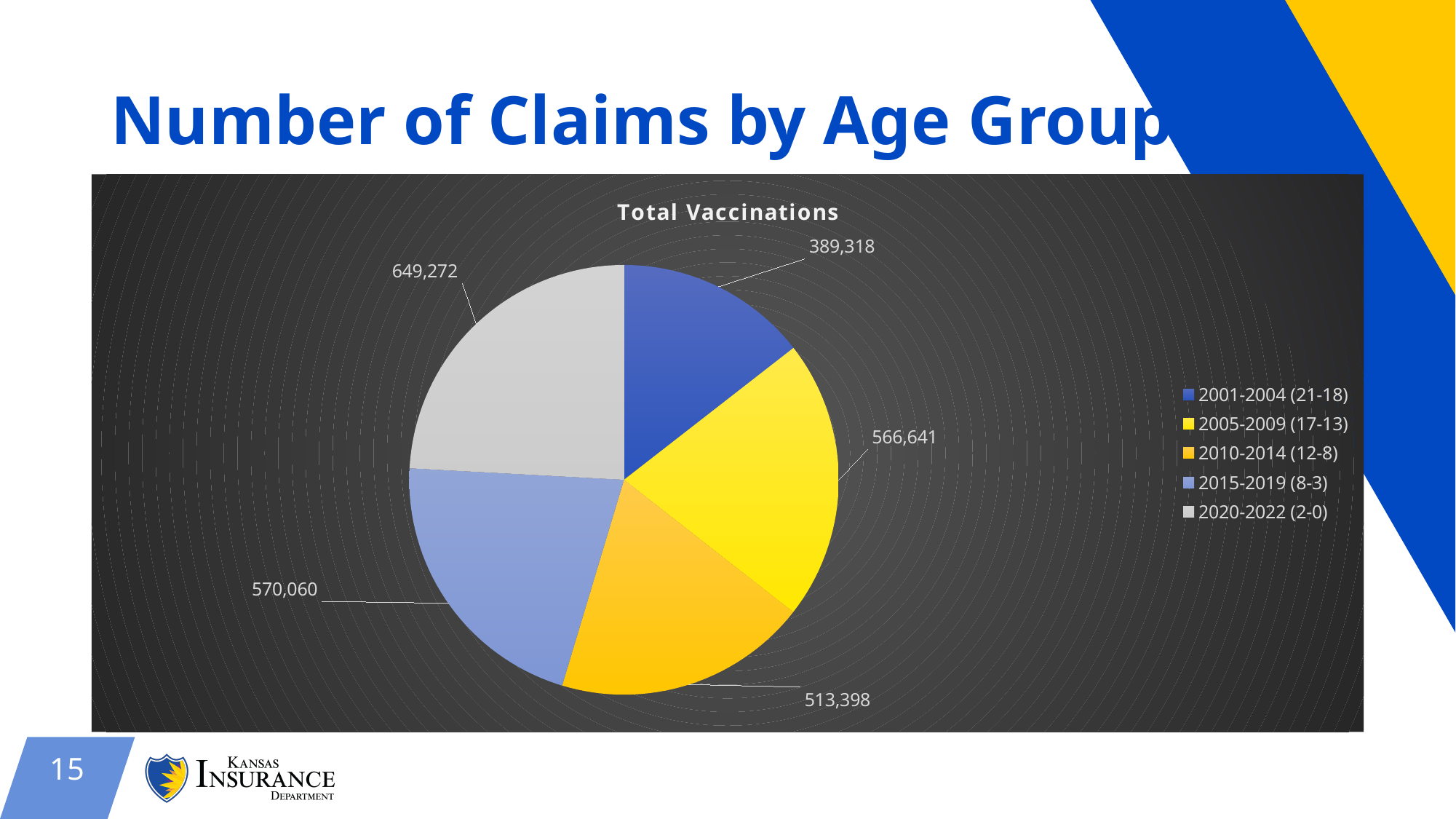
What is the difference between the values for 2020-2022 (2-0) and 2001-2004 (21-18)? 259,954 What is the title of the chart? Total Vaccinations What is the value for the 2010-2014 (12-8) age group? 513,398 How many entries does the legend list? 5 Which is larger, the value for 2015-2019 (8-3) or the value for 2005-2009 (17-13)? 2015-2019 (8-3) What is the value for the 2020-2022 (2-0) age group? 649,272 Which age group has the largest number of claims? 2020-2022 (2-0) What is the value for the 2001-2004 (21-18) age group? 389,318 What colour is the slice for the 2020-2022 (2-0) age group? Grey Which age group has the smallest number of claims? 2001-2004 (21-18) What type of chart is shown on the slide? Pie chart How many slices does the pie chart have? 5